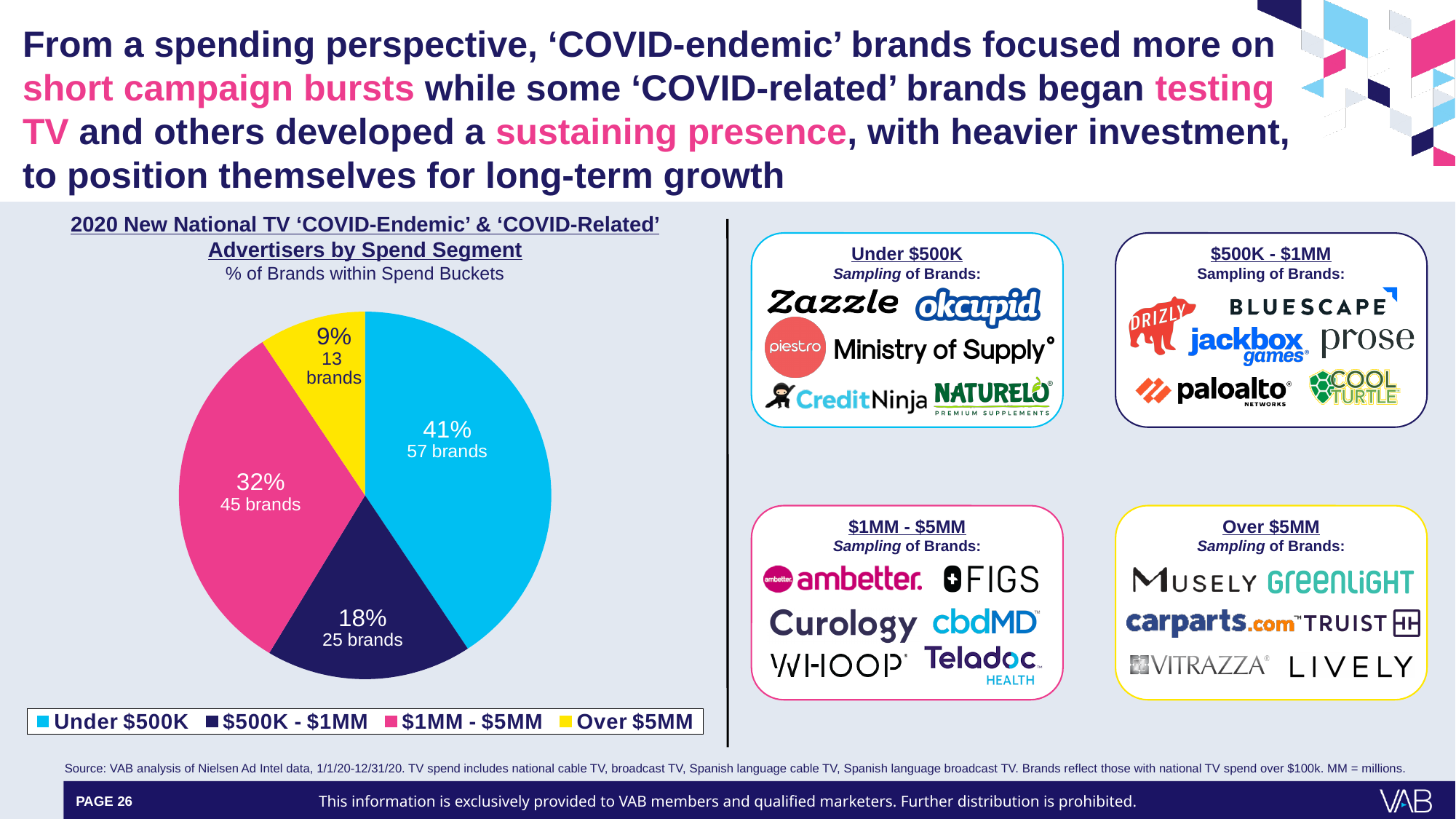
How many spend segments are shown in the pie chart? 4 What is the difference in percentage points between the Under $500K and $1MM - $5MM segments? 9 percentage points What type of chart is used to show brands by spend segment? Pie chart What percentage of brands are in the Over $5MM spend segment? 9% What colour represents the $1MM - $5MM segment in the pie chart? Pink What is the total number of brands across all four spend segments? 140 brands How many brands are in the $1MM - $5MM spend segment? 45 brands How many brands are in the $500K - $1MM spend segment? 25 brands What percentage of brands fall in the Under $500K spend segment? 41% Which spend segment has the smallest share of brands? Over $5MM Which spend segment has the largest share of brands? Under $500K Which segment has more brands, $500K - $1MM or Over $5MM? $500K - $1MM